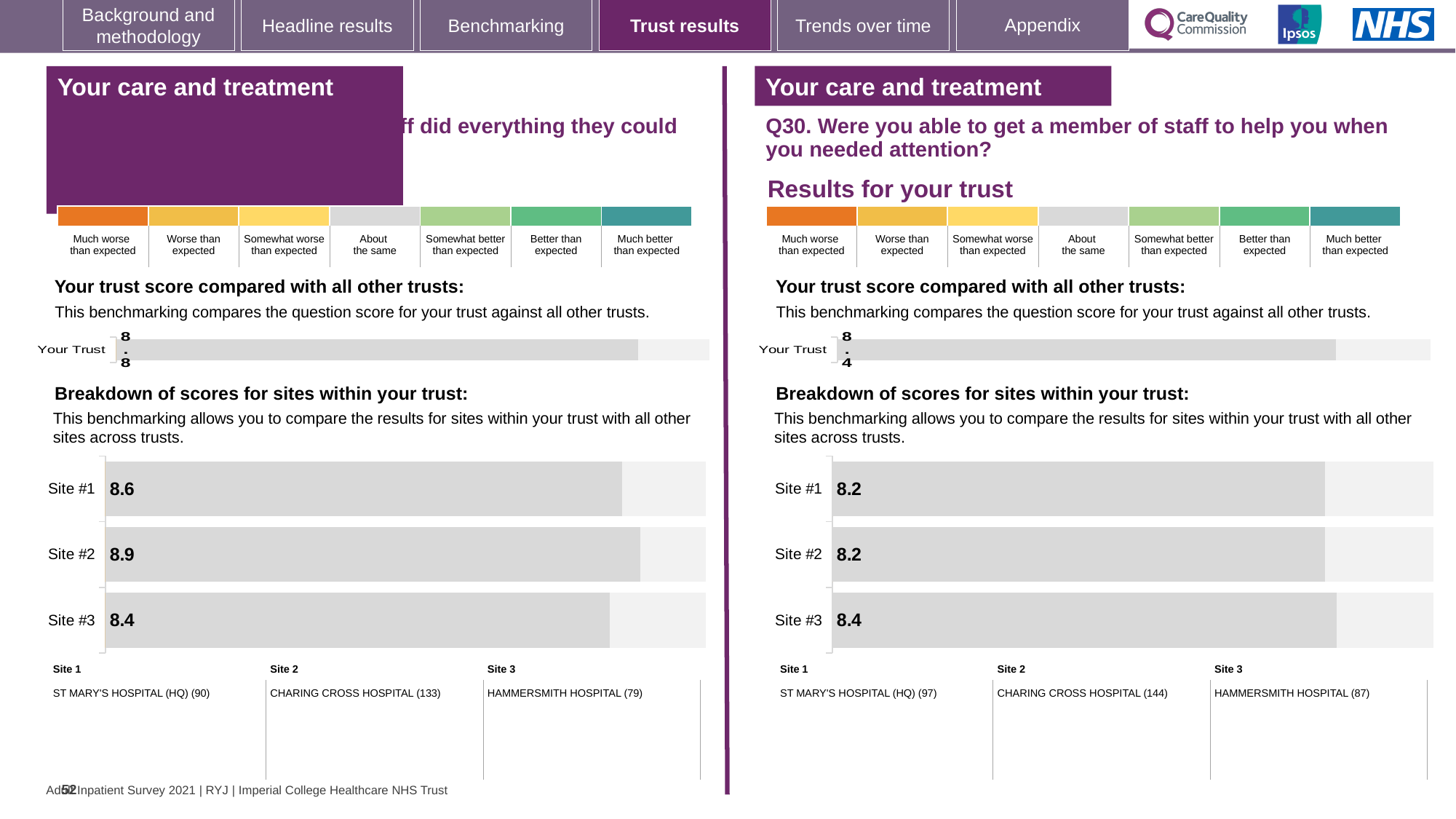
On the Q30 panel's site breakdown chart, what is the difference between the scores for Site #3 and Site #1? 0.2 On the Q30 panel's 'Your trust score compared with all other trusts' chart, what is the score for Your Trust? 8.4 On the Q30 panel's site breakdown chart, how many sites are shown? 3 On the Q30 panel's 'Breakdown of scores for sites within your trust' chart, what is the score for Site #3? 8.4 What type of chart is used for the site breakdown on the left panel? Bar chart On the left panel's site breakdown chart, what is the difference between the scores for Site #2 and Site #3? 0.5 On the left panel's 'Breakdown of scores for sites within your trust' chart, what is the score for Site #2? 8.9 Is the score for Site #1 on the left panel's site breakdown chart larger or smaller than the score for Site #1 on the Q30 panel's site breakdown chart? Larger On the Q30 panel's site breakdown chart, which site has the highest score? Site #3 On the left panel's site breakdown chart, which site has the highest score? Site #2 On the left panel's site breakdown chart, which site has the lowest score? Site #3 On the left panel's 'Your trust score compared with all other trusts' chart, what is the score for Your Trust? 8.8